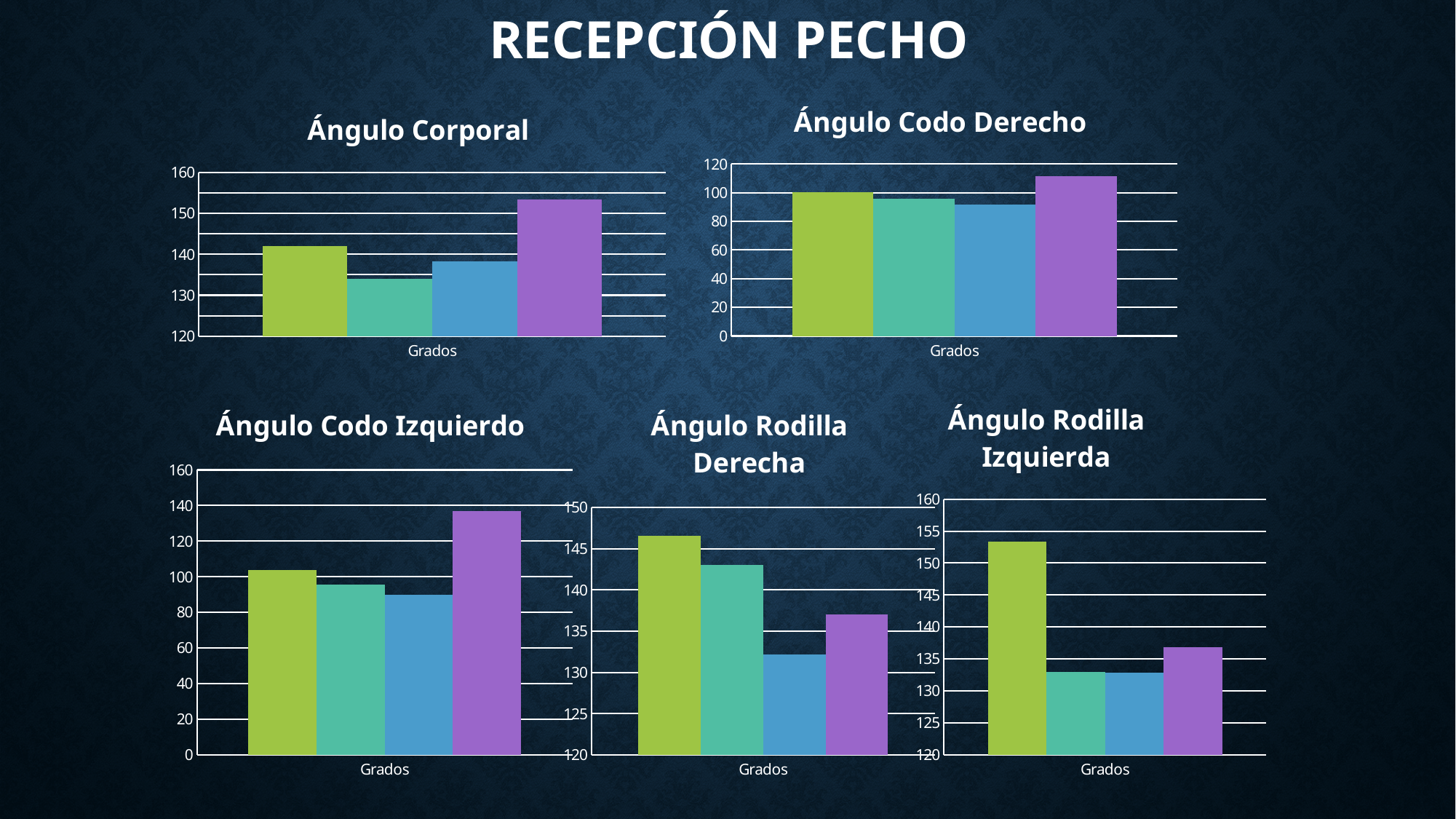
In the "Ángulo Codo Derecho" chart, is the value of the purple bar greater or less than 100? greater In the "Ángulo Rodilla Izquierda" chart, which is larger, the green bar or the purple bar? The green bar In the "Ángulo Codo Izquierdo" chart, is the value of the purple bar greater or less than 120? greater In the "Ángulo Rodilla Derecha" chart, which bar is the highest? The green bar In the "Ángulo Corporal" chart, which bar is the highest? The purple bar In the "Ángulo Codo Izquierdo" chart, which bar is the lowest? The blue bar How many bars are plotted in the "Ángulo Corporal" chart? 4 What kind of chart is the "Ángulo Corporal" chart? Bar chart In the "Ángulo Codo Derecho" chart, which bar is the highest? The purple bar In the "Ángulo Corporal" chart, is the value of the purple bar greater or less than 150? greater In the "Ángulo Corporal" chart, which bar is the lowest? The teal bar What is the x-axis label shown under the "Ángulo Rodilla Izquierda" chart? Grados